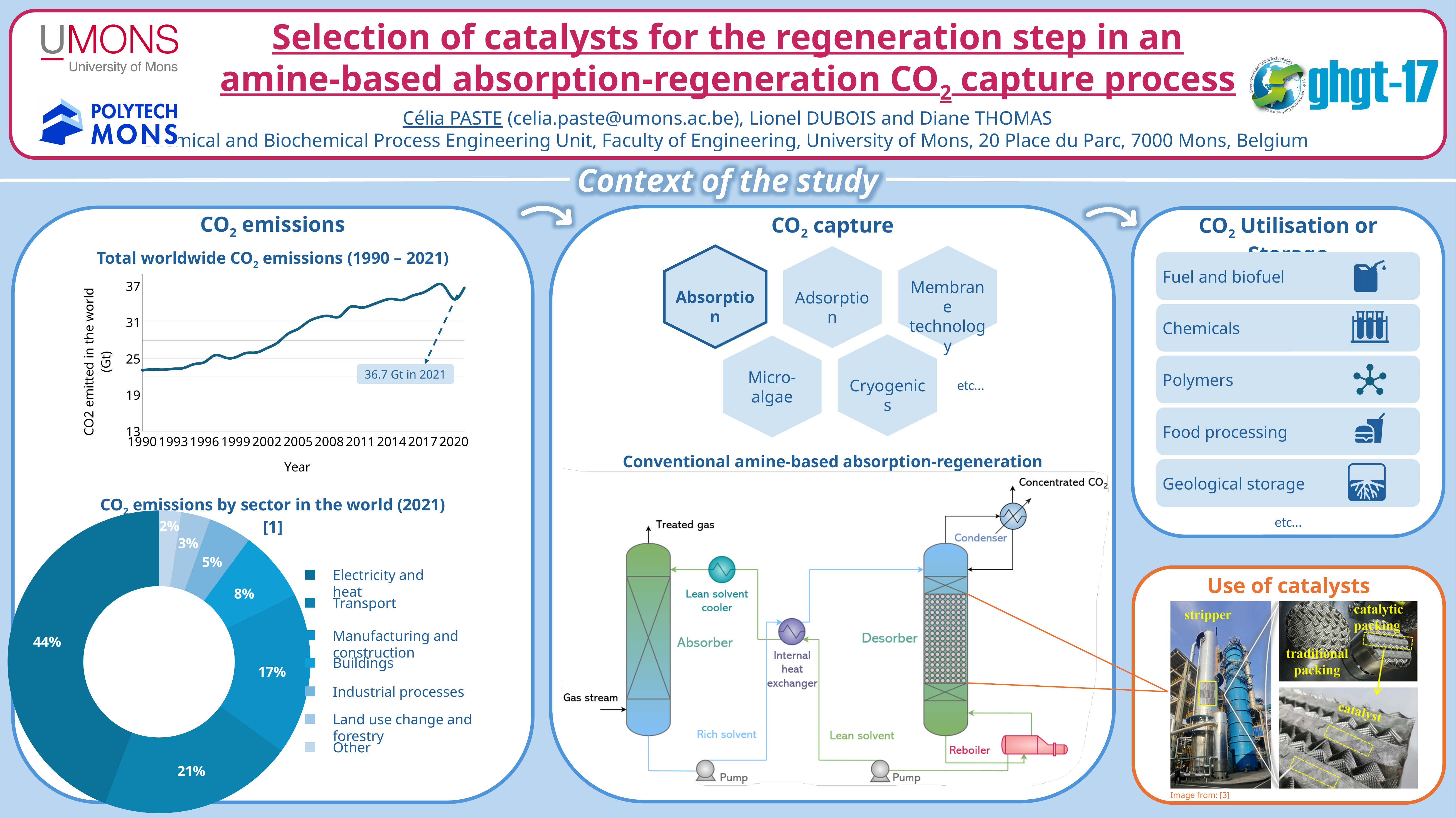
In the 'CO2 emissions by sector in the world (2021)' chart, what share is Transport? 21% In the 'CO2 emissions by sector in the world (2021)' chart, how many sectors does the legend list? 7 In the 'CO2 emissions by sector in the world (2021)' chart, what share is Electricity and heat? 44% In the 'Total worldwide CO2 emissions (1990 – 2021)' chart, do emissions generally rise or fall from 1990 to 2021? rise In the 'Total worldwide CO2 emissions (1990 – 2021)' chart, is the value for 1990 greater or less than 25? less In the 'CO2 emissions by sector in the world (2021)' chart, which sector has the largest share? Electricity and heat In the 'CO2 emissions by sector in the world (2021)' chart, which sector has the smallest share? Other In the 'Total worldwide CO2 emissions (1990 – 2021)' chart, what value is labelled for 2021? 36.7 Gt In the 'CO2 emissions by sector in the world (2021)' chart, what kind of chart is shown? doughnut chart In the 'Total worldwide CO2 emissions (1990 – 2021)' chart, is the value for 2008 greater or less than 25? greater In the 'CO2 emissions by sector in the world (2021)' chart, what is the difference between the Transport share and the Manufacturing and construction share? 4% In the 'Total worldwide CO2 emissions (1990 – 2021)' chart, what kind of chart is shown? line chart